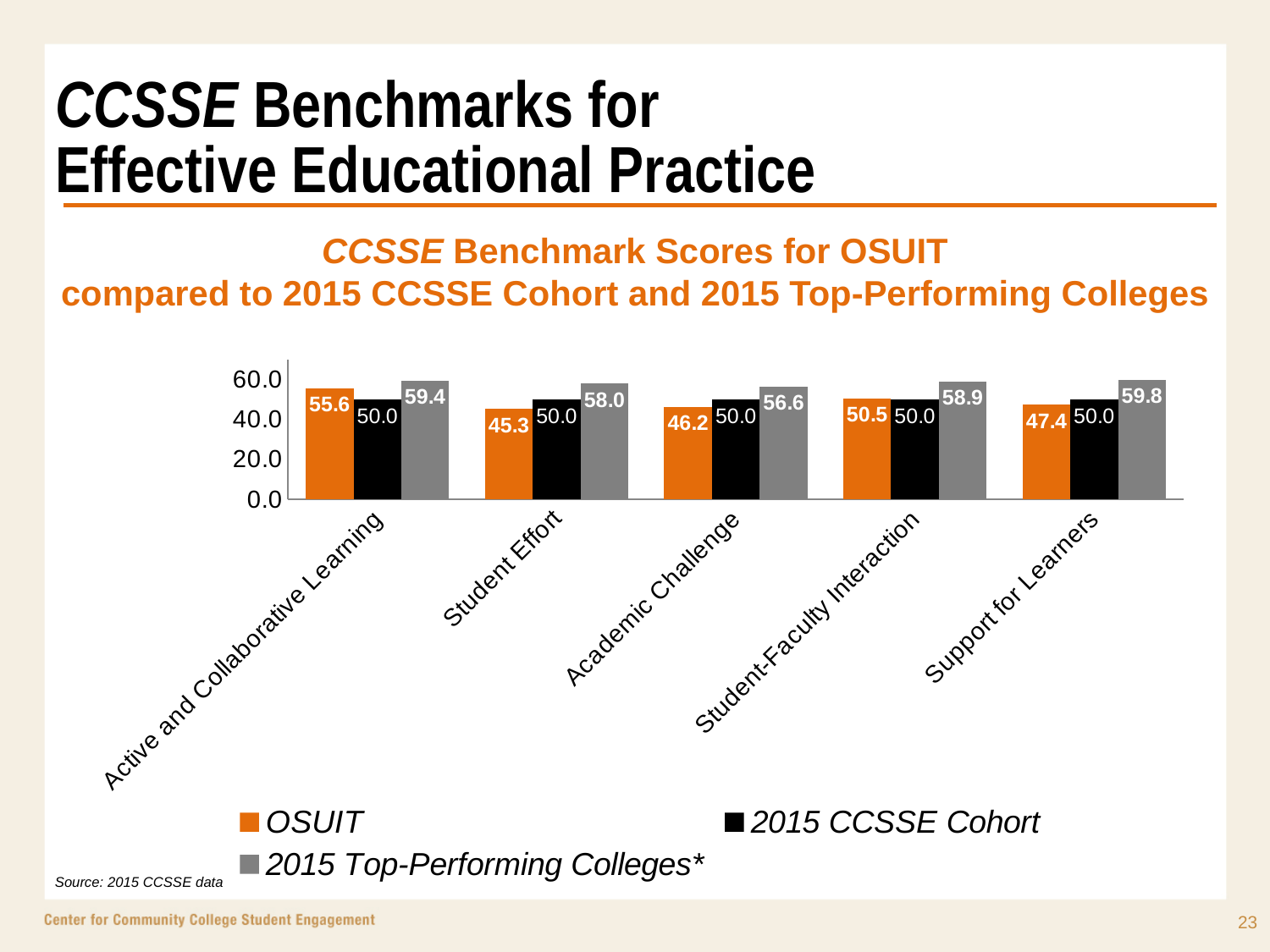
What is the 2015 CCSSE Cohort score for Academic Challenge? 50.0 What is the difference between the 2015 Top-Performing Colleges score and the OSUIT score for Student-Faculty Interaction? 8.4 Which is larger for Academic Challenge: the OSUIT score or the 2015 CCSSE Cohort score? 2015 CCSSE Cohort Which benchmark has the lowest OSUIT score? Student Effort How many benchmark categories are shown on the x axis? 5 How many series does the legend list? 3 Which benchmark has the highest OSUIT score? Active and Collaborative Learning What kind of chart is shown on the slide? Bar chart What is the OSUIT score for Active and Collaborative Learning? 55.6 What is the 2015 Top-Performing Colleges score for Student Effort? 58.0 Which colour represents OSUIT in the chart? Orange What is the OSUIT score for Support for Learners? 47.4